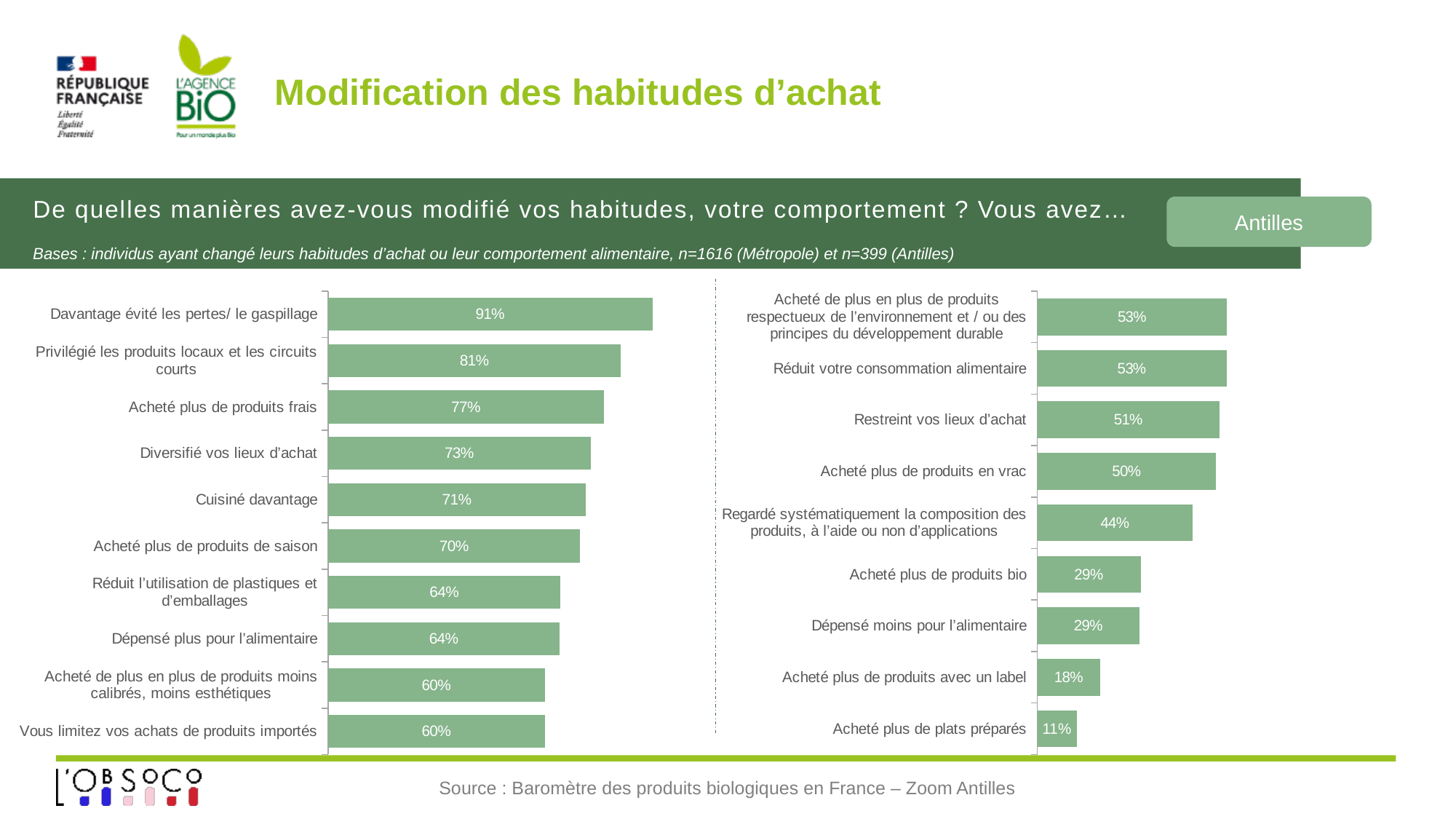
On the right chart, what is the value for "Acheté plus de produits en vrac"? 50% How many categories are shown on the right chart? 9 On the left chart, what is the difference between "Privilégié les produits locaux et les circuits courts" and "Acheté plus de produits frais"? 4% On the left chart, what is the value for "Davantage évité les pertes/ le gaspillage"? 91% On the left chart, what is the value for "Cuisiné davantage"? 71% On the right chart, what is the value for "Acheté plus de produits bio"? 29% On the left chart, which category has the highest value? Davantage évité les pertes/ le gaspillage How many categories are shown on the left chart? 10 On the right chart, which category has the lowest value? Acheté plus de plats préparés On the right chart, which is larger: "Regardé systématiquement la composition des produits, à l'aide ou non d'applications" or "Dépensé moins pour l'alimentaire"? Regardé systématiquement la composition des produits, à l'aide ou non d'applications What type of chart is used on the left side of the slide? Bar chart On the right chart, what is the difference between "Restreint vos lieux d'achat" and "Acheté plus de produits avec un label"? 33%